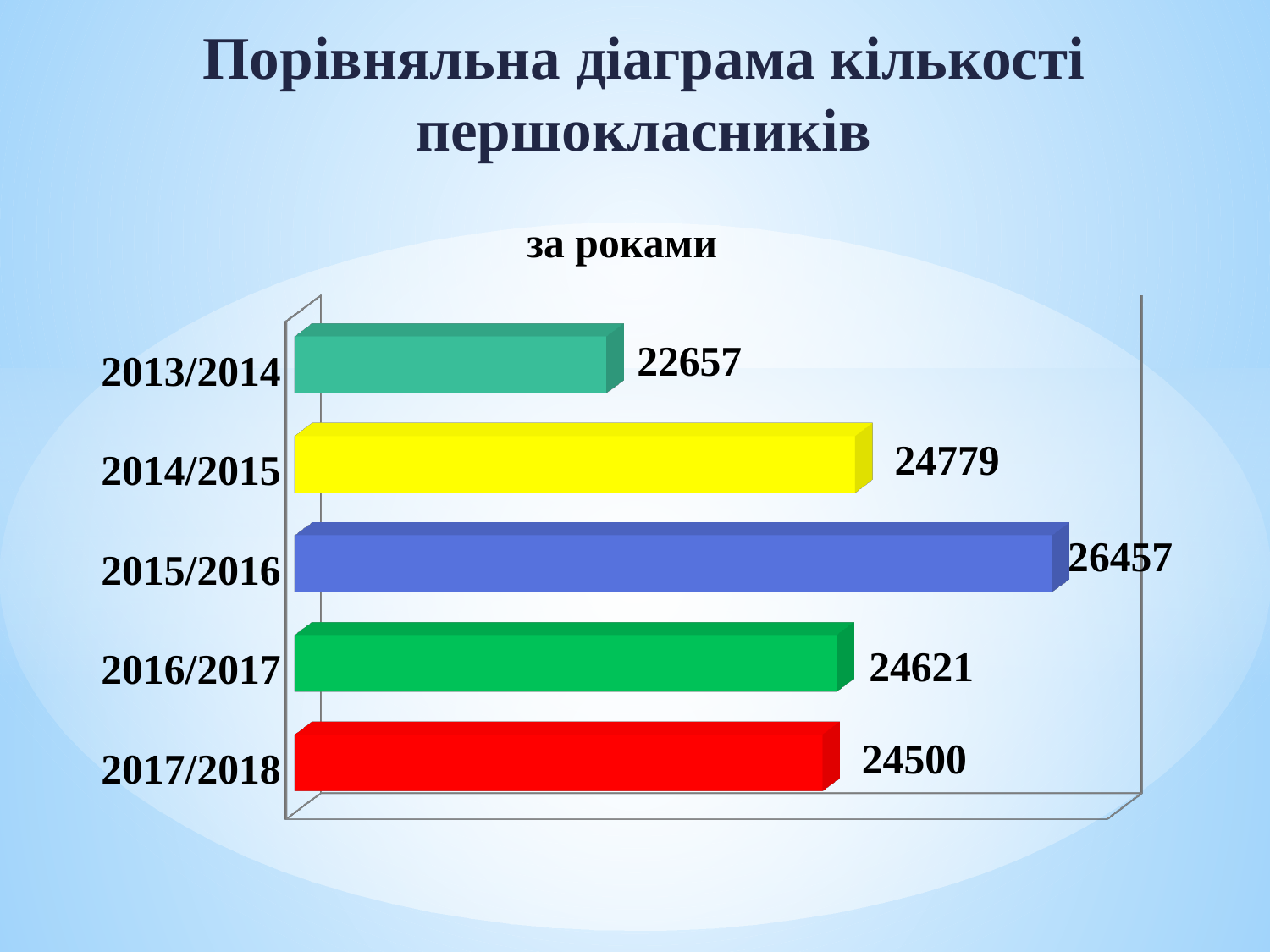
What is the difference between the values for 2015/2016 and 2013/2014? 3800 What is the value for 2013/2014? 22657 What kind of chart is shown on the slide? bar chart Which is larger, the value for 2014/2015 or the value for 2017/2018? 2014/2015 How many years are shown in the chart? 5 What colour is the bar for 2017/2018? red What is the difference between the values for 2014/2015 and 2016/2017? 158 Which year has the highest value? 2015/2016 What is the value for 2017/2018? 24500 What is the value for 2015/2016? 26457 Which year has the lowest value? 2013/2014 What is the title of the chart? за роками